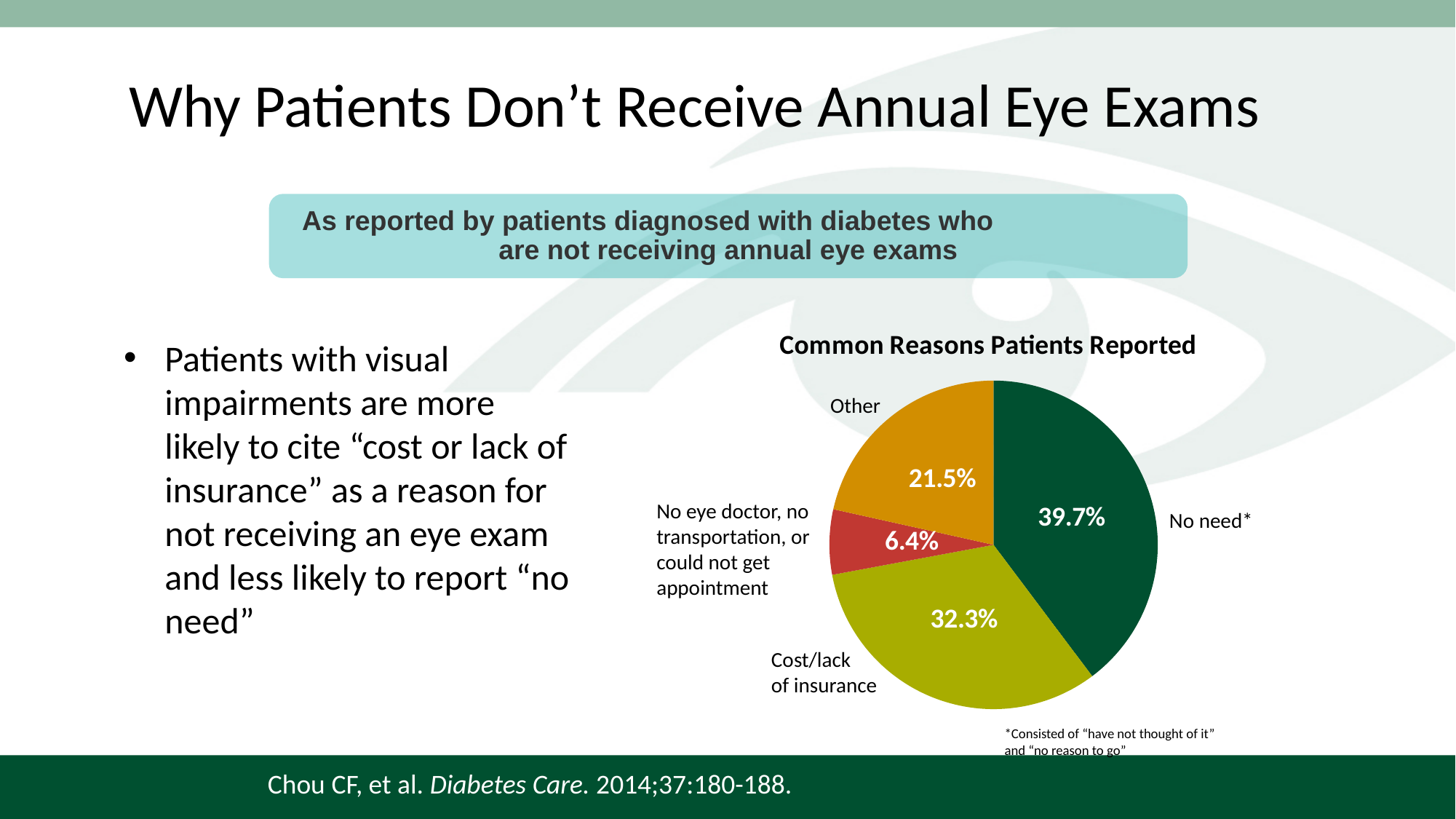
What percentage is shown for the "Other" slice? 21.5% What percentage of patients reported "No need*" as a reason? 39.7% What percentage of patients reported "Cost/lack of insurance"? 32.3% What kind of chart is shown on the slide? Pie chart How many slices does the pie chart have? 4 What is the title of the chart? Common Reasons Patients Reported Which reason has the smallest share of the pie? No eye doctor, no transportation, or could not get appointment What is the difference in percentage points between "No need*" and "Cost/lack of insurance"? 7.4 Which is larger, the share for "Other" or the share for "No eye doctor, no transportation, or could not get appointment"? Other What colour is the "Cost/lack of insurance" slice? Yellow-green Which reason has the largest share of the pie? No need* What percentage is shown for "No eye doctor, no transportation, or could not get appointment"? 6.4%